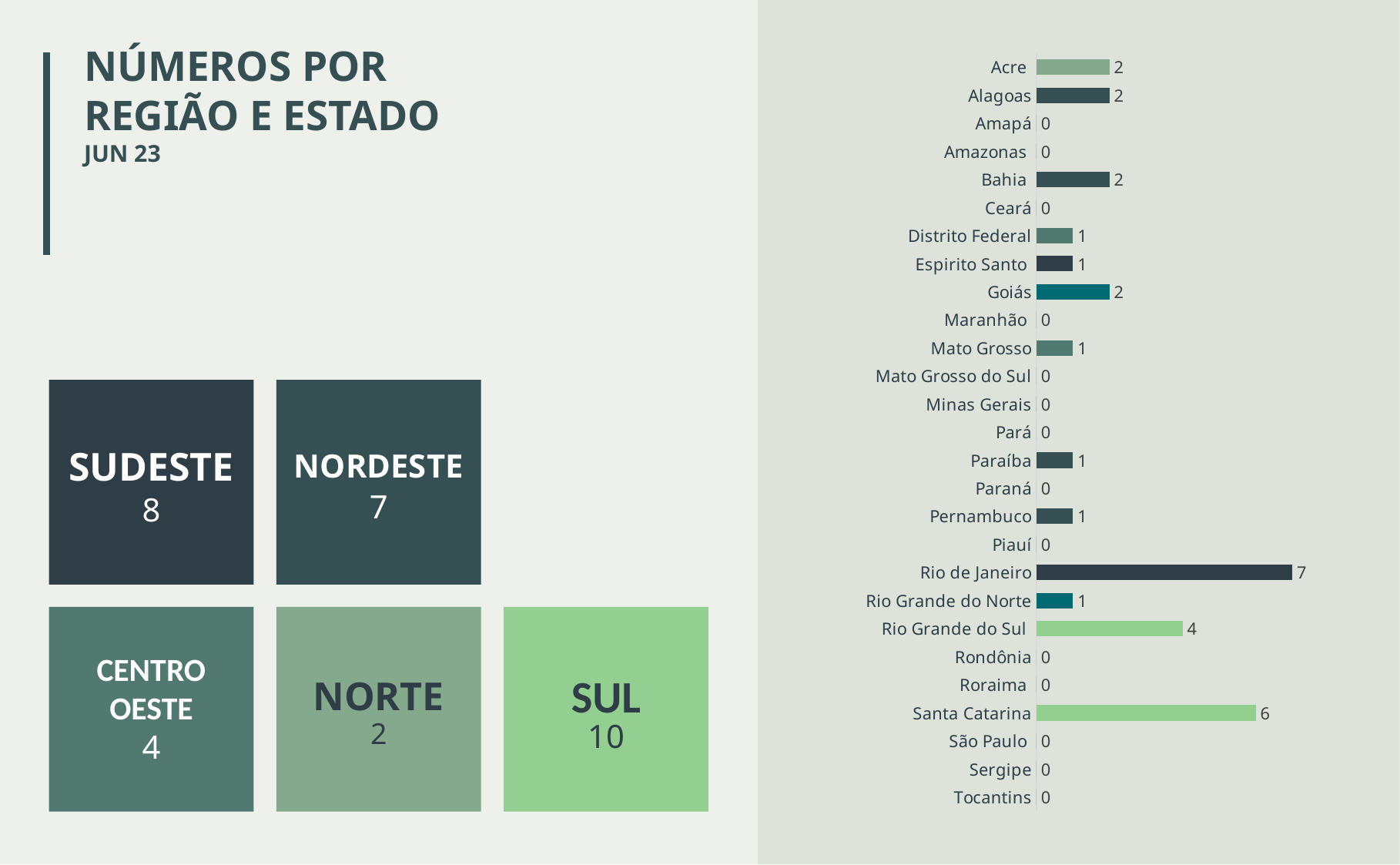
How many states are listed in the bar chart? 27 What is the value for Rio Grande do Sul in the bar chart? 4 What is the difference between the values for Rio Grande do Sul and Acre? 2 Which state has the highest value in the bar chart? Rio de Janeiro What is the value for Santa Catarina in the bar chart? 6 How many states in the bar chart have a value of 0? 14 Which has a larger value, Santa Catarina or Rio Grande do Sul? Santa Catarina What is the value for Goiás in the bar chart? 2 What kind of chart is shown on the right side of the slide? Bar chart What is the value for São Paulo in the bar chart? 0 What is the value for Rio de Janeiro in the bar chart? 7 What is the difference between the values for Rio de Janeiro and Santa Catarina? 1